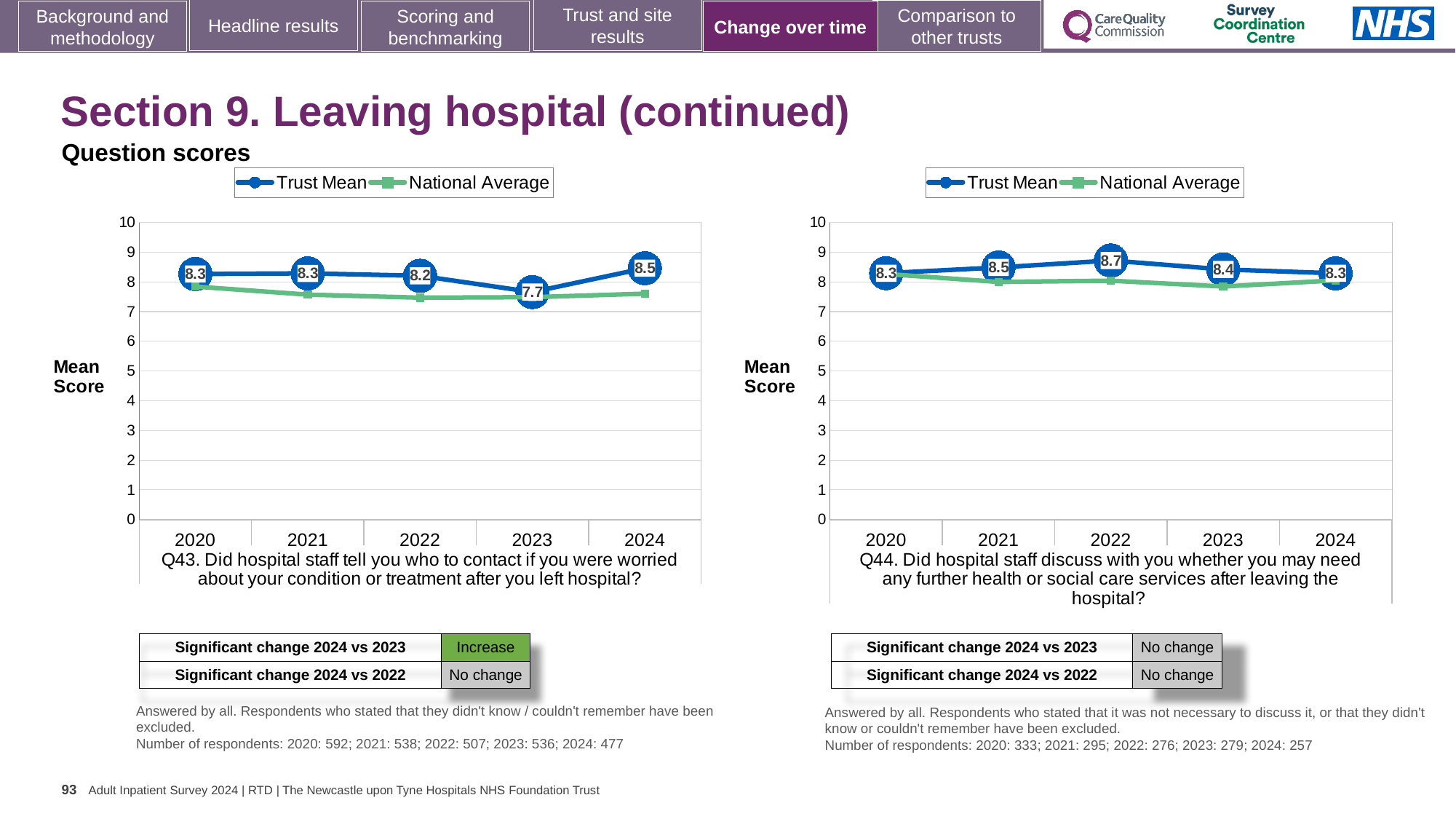
In the Q43 chart on the left, which year has the lowest Trust Mean score? 2023 What type of chart is the Q44 chart on the right? Line chart In the Q43 chart on the left, is the National Average value for 2022 greater or less than 8? less In the Q43 chart on the left, what does the table say about the significant change 2024 vs 2023? Increase In the Q43 chart on the left, what is the Trust Mean score for 2023? 7.7 How many series does the legend of the Q43 chart on the left list? 2 In the Q44 chart on the right, what is the Trust Mean score for 2022? 8.7 In the Q43 chart on the left, what is the Trust Mean score for 2024? 8.5 In the Q44 chart on the right, which is larger, the Trust Mean score for 2021 or for 2023? 2021 How many years are plotted on the x axis of the Q44 chart on the right? 5 In the Q43 chart on the left, what is the difference between the Trust Mean scores for 2024 and 2023? 0.8 In the Q44 chart on the right, which year has the highest Trust Mean score? 2022